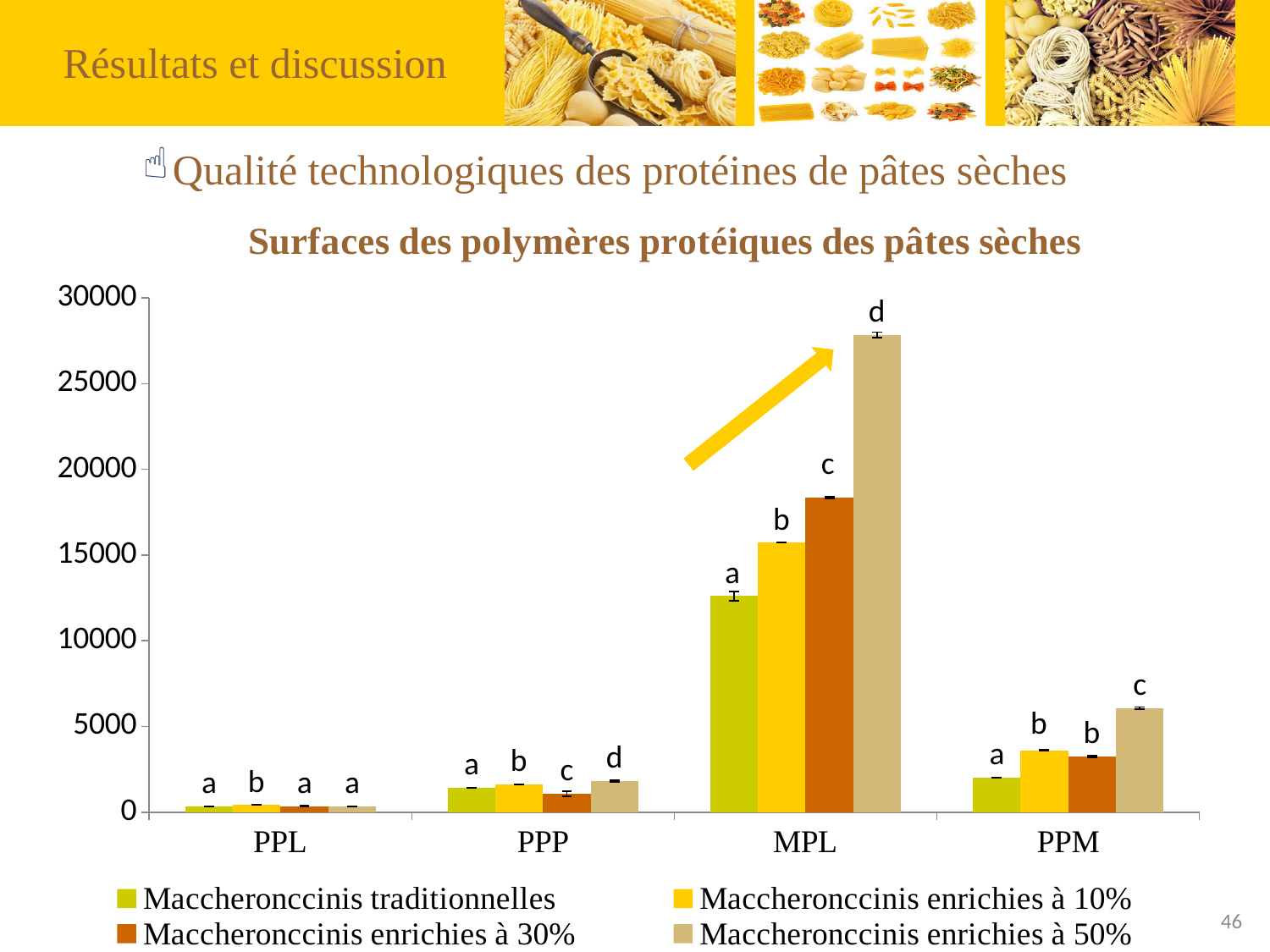
How many categories are shown on the x axis of the chart? 4 Which series is shown in light green in the chart? Maccheronccinis traditionnelles Which category has the highest value for Maccheronccinis enrichies à 50%? MPL Is the value for Maccheronccinis enrichies à 50% in PPM greater or less than 5000? greater What is the title of the chart? Surfaces des polymères protéiques des pâtes sèches How many series does the chart's legend list? 4 In the MPL category, do the values rise or fall going from Maccheronccinis traditionnelles to Maccheronccinis enrichies à 50%? rise Is the value for Maccheronccinis enrichies à 50% in MPL greater or less than 25000? greater In the MPL category, which is larger: Maccheronccinis enrichies à 10% or Maccheronccinis enrichies à 30%? Maccheronccinis enrichies à 30% Which category has the lowest value for Maccheronccinis traditionnelles? PPL Is the value for Maccheronccinis traditionnelles in MPL greater or less than 15000? less What kind of chart is shown on the slide? bar chart